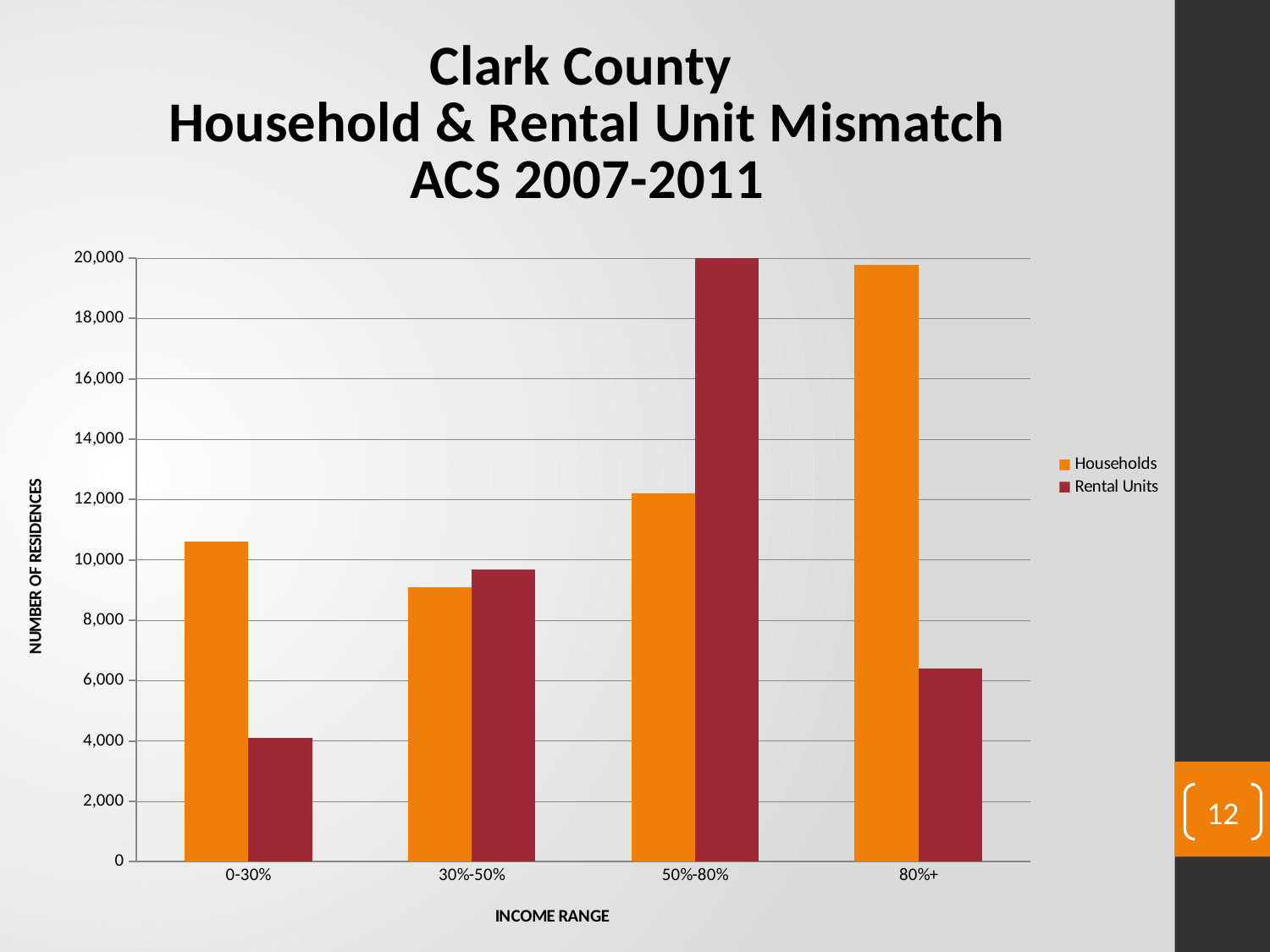
Is the value for Households in the 80%+ income range greater or less than 18,000? greater Is the value for Rental Units in the 80%+ income range greater or less than 8,000? less What is the title of the vertical axis? NUMBER OF RESIDENCES How many income range categories are shown on the x axis? 4 How many series does the legend list? 2 Which income range has the highest value for Rental Units? 50%-80% In the 50%-80% income range, which is larger, Households or Rental Units? Rental Units Which income range has the lowest value for Households? 30%-50% Which income range has the lowest value for Rental Units? 0-30% Which income range has the highest value for Households? 80%+ In the 0-30% income range, which is larger, Households or Rental Units? Households What kind of chart is shown on the slide? bar chart